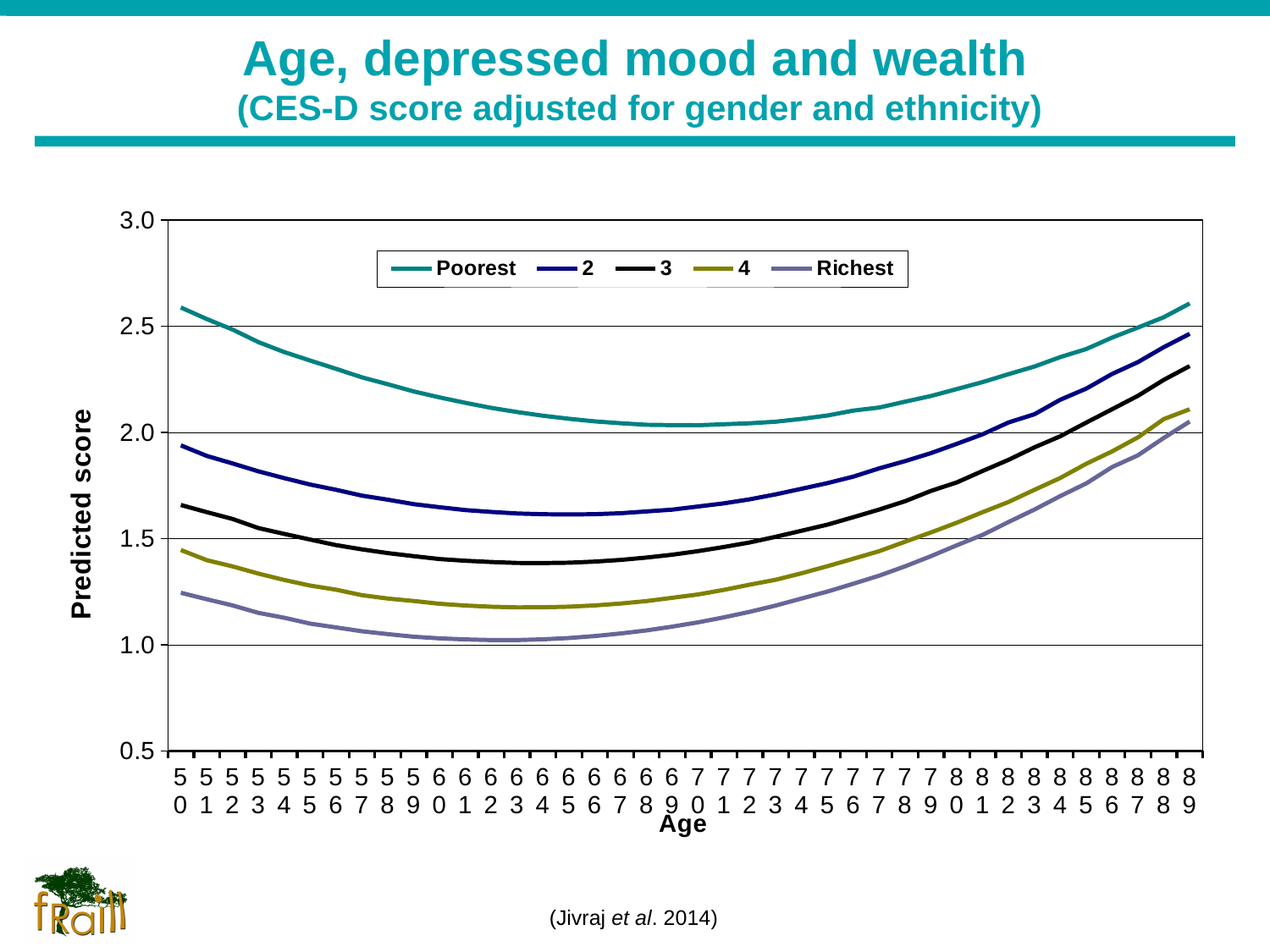
At age 70, which has the larger predicted score, the Poorest group or the Richest group? Poorest What is the label of the y axis? Predicted score Which wealth group has the lowest predicted score across all ages? Richest Is the predicted score for the Richest group at age 50 greater or less than 1.0? greater What kind of chart is shown on the slide? line chart Is the predicted score for group 2 at age 50 greater or less than 2.0? less How does the predicted score for the Poorest group change from age 70 to age 89? it rises How many age values are shown along the x axis? 40 Which wealth group has the highest predicted score across all ages? Poorest Is the predicted score for group 3 at age 89 greater or less than 2.0? greater How many series does the legend list? 5